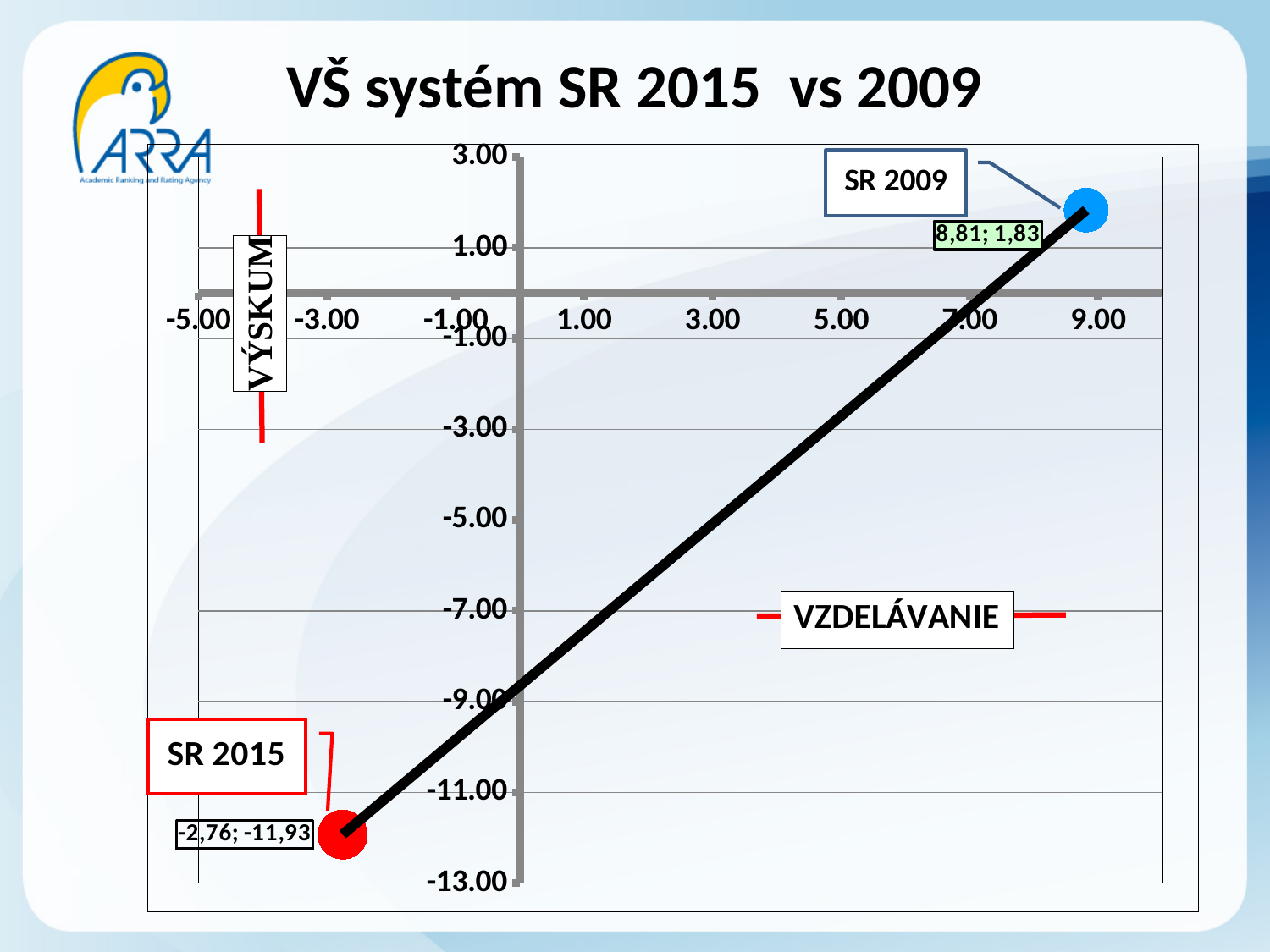
What are the coordinates printed for the SR 2009 point? 8,81; 1,83 What is the title of the slide's chart? VŠ systém SR 2015 vs 2009 What kind of chart is shown on the slide? scatter chart Which point has the lower VZDELÁVANIE value, SR 2009 or SR 2015? SR 2015 What is the VÝSKUM (vertical axis) value printed for SR 2015? -11,93 Is the VZDELÁVANIE value for SR 2009 greater or less than 7.00? greater What label is given to the horizontal axis of the chart? VZDELÁVANIE How many labelled data points are plotted on the chart? 2 Which point has the higher VÝSKUM value, SR 2009 or SR 2015? SR 2009 What is the VZDELÁVANIE (horizontal axis) value printed for SR 2009? 8,81 Is the VÝSKUM value for SR 2015 greater or less than -11.00? less What are the coordinates printed for the SR 2015 point? -2,76; -11,93